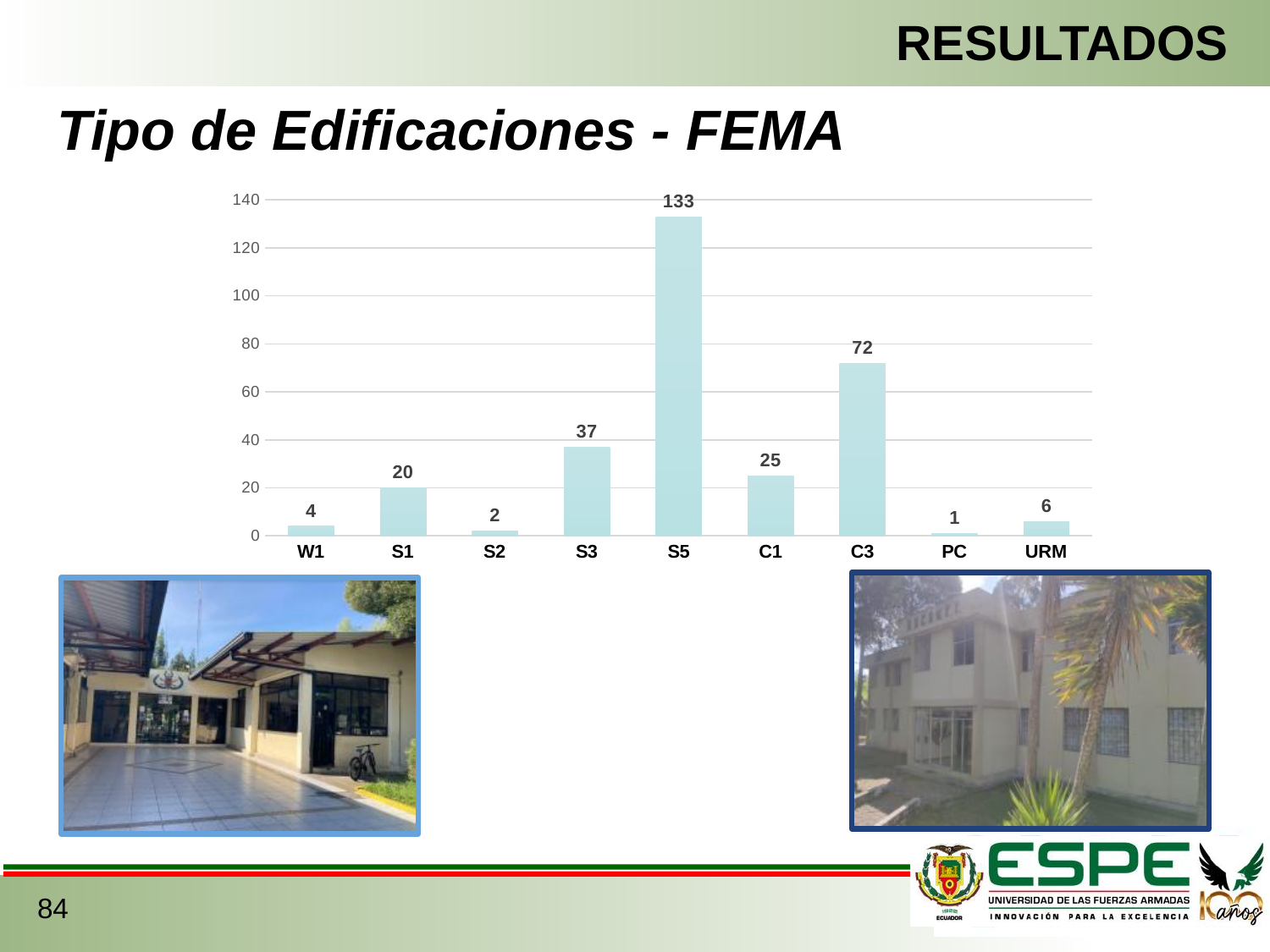
What is the difference between the values for S5 and C3? 61 What is the difference between the values for S1 and URM? 14 What is the value for W1? 4 What is the value for S5? 133 Which category has the highest value? S5 Which is larger, the value for S3 or the value for C1? S3 What kind of chart is shown on the slide? bar chart What is the title of the slide above the chart? Tipo de Edificaciones - FEMA Is the value for C3 greater or less than 60? greater Which category has the lowest value? PC How many categories are shown on the x axis? 9 What is the value for C3? 72